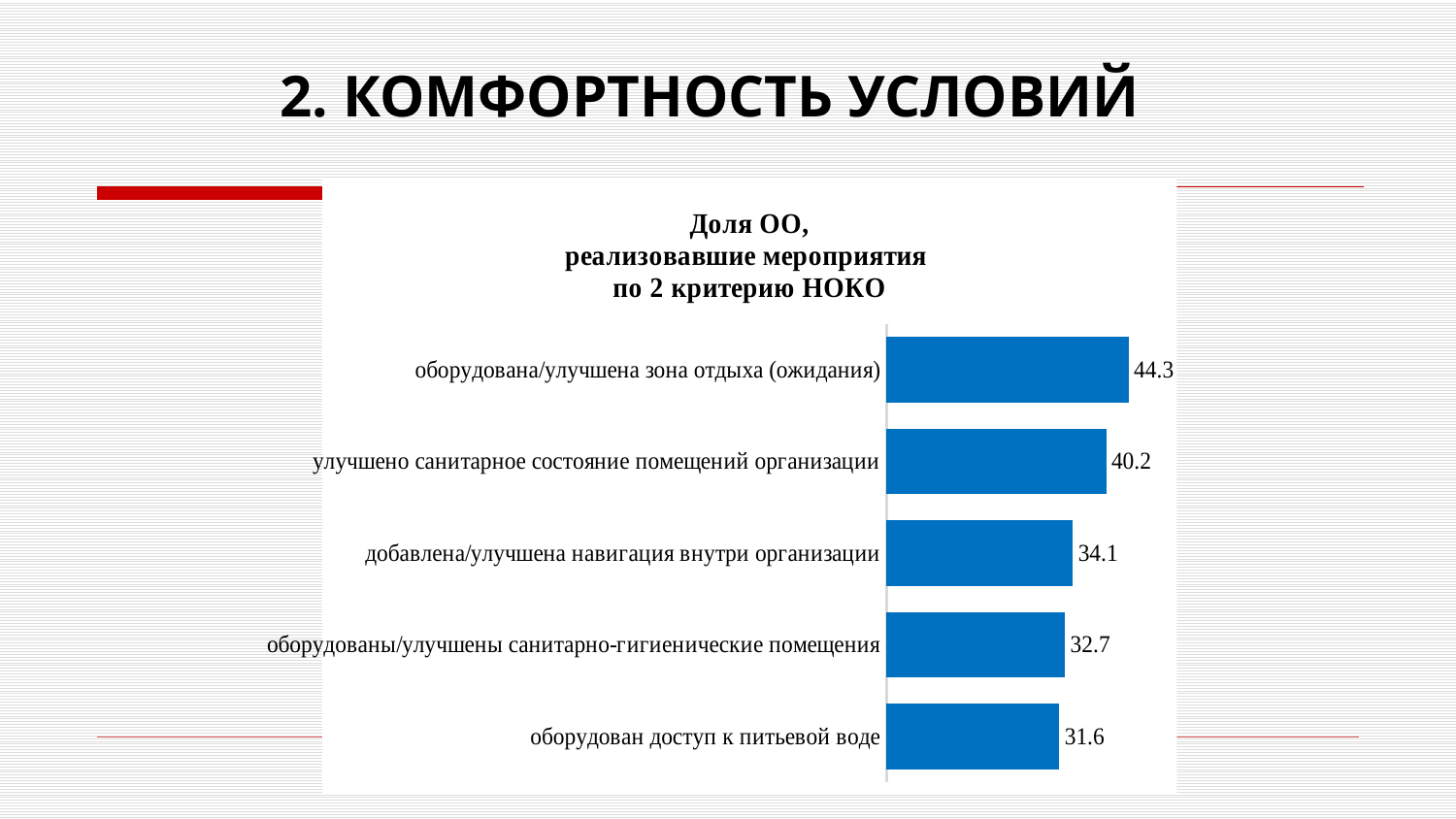
What kind of chart is shown on the slide? bar chart What is the difference between the values for "оборудованы/улучшены санитарно-гигиенические помещения" and "оборудован доступ к питьевой воде"? 1.1 Which is larger: the value for "улучшено санитарное состояние помещений организации" or for "добавлена/улучшена навигация внутри организации"? улучшено санитарное состояние помещений организации Which category has the highest value? оборудована/улучшена зона отдыха (ожидания) What is the value for "добавлена/улучшена навигация внутри организации"? 34.1 What is the difference between the values for "оборудована/улучшена зона отдыха (ожидания)" and "улучшено санитарное состояние помещений организации"? 4.1 Which category has the lowest value? оборудован доступ к питьевой воде What colour are the bars in the chart? blue What is the value for "оборудована/улучшена зона отдыха (ожидания)"? 44.3 How many categories are shown in the chart? 5 What is the title of the chart? Доля ОО, реализовавшие мероприятия по 2 критерию НОКО What is the value for "оборудован доступ к питьевой воде"? 31.6